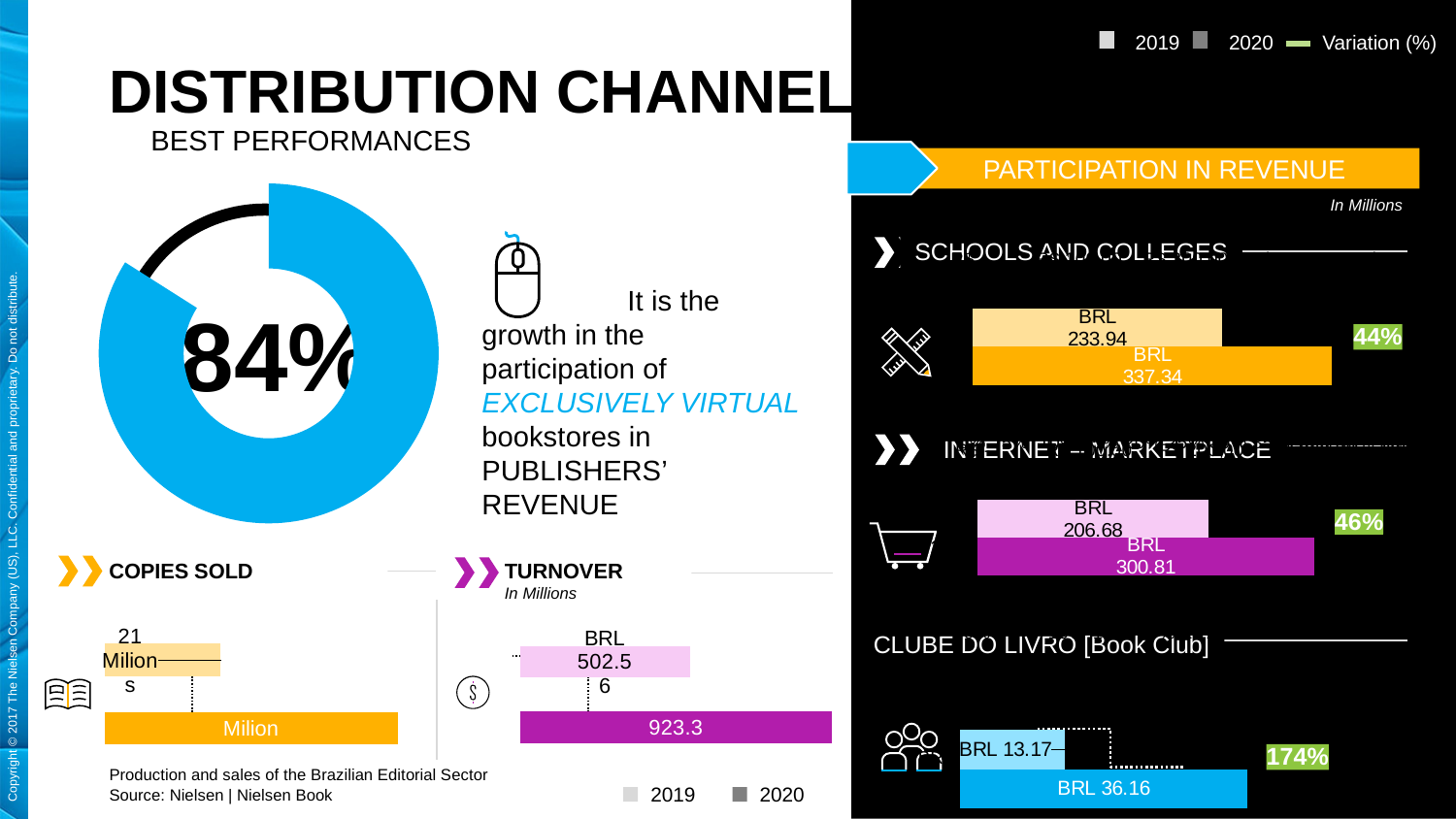
In the PARTICIPATION IN REVENUE chart, what is the 2019 value for INTERNET – MARKETPLACE? BRL 206.68 In the PARTICIPATION IN REVENUE chart, what is the 2020 value for CLUBE DO LIVRO [Book Club]? BRL 36.16 In the PARTICIPATION IN REVENUE chart, which channel has the lowest 2020 value? CLUBE DO LIVRO [Book Club] What percentage is shown in the donut chart on the left of the slide? 84% In the PARTICIPATION IN REVENUE chart, what is the variation (%) shown for CLUBE DO LIVRO [Book Club]? 174% In the TURNOVER chart, what is the value for 2020? 923.3 How many series does the legend of the PARTICIPATION IN REVENUE chart list? 3 In the PARTICIPATION IN REVENUE chart, what is the 2020 value for SCHOOLS AND COLLEGES? BRL 337.34 How many channels are shown in the PARTICIPATION IN REVENUE chart? 3 In the PARTICIPATION IN REVENUE chart, which channel has the highest variation (%)? CLUBE DO LIVRO [Book Club] In the PARTICIPATION IN REVENUE chart, which is larger: the 2020 value for SCHOOLS AND COLLEGES or the 2020 value for INTERNET – MARKETPLACE? SCHOOLS AND COLLEGES In the PARTICIPATION IN REVENUE chart, what is the difference between the 2020 and 2019 values for SCHOOLS AND COLLEGES? BRL 103.40